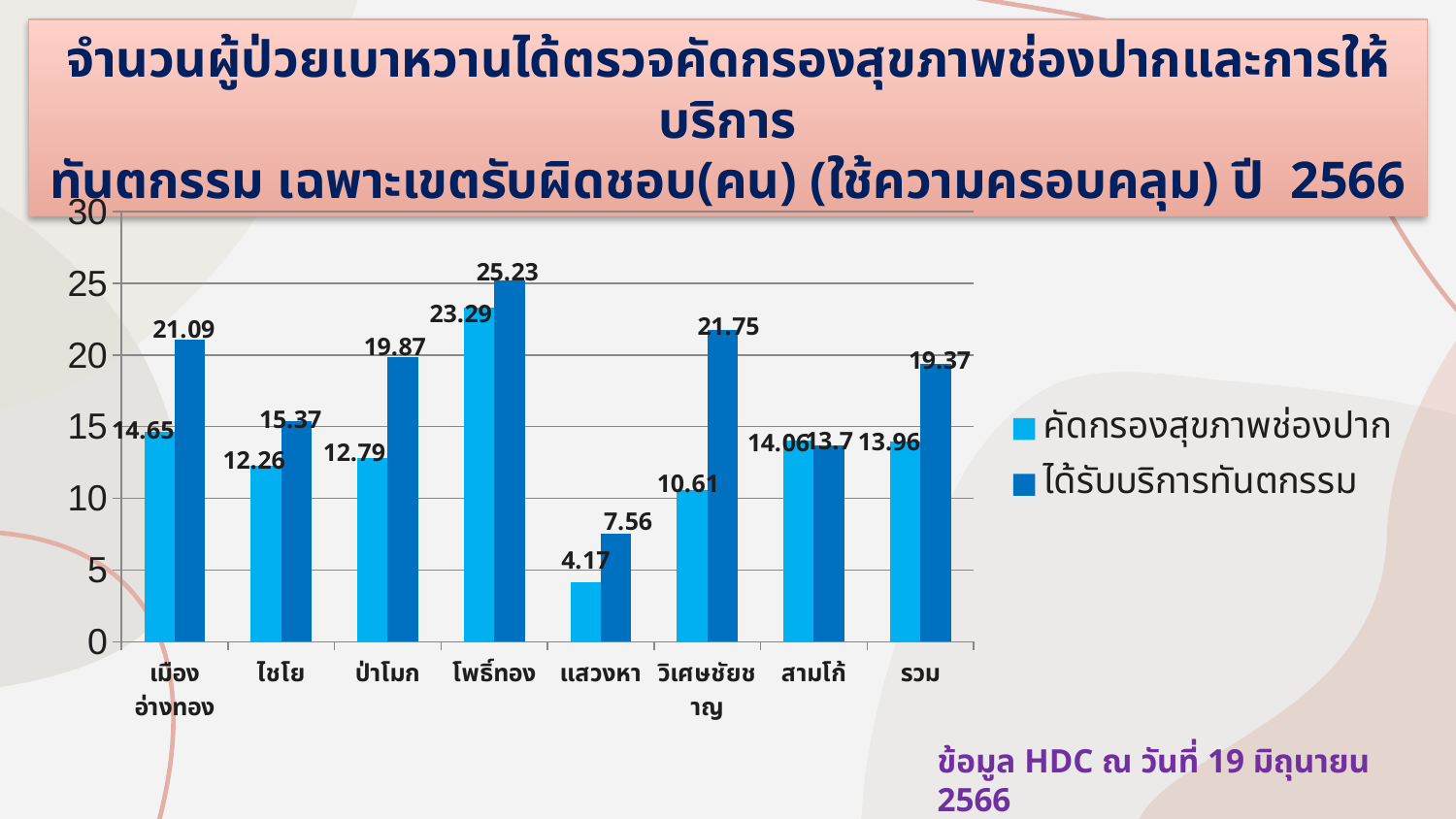
What is the difference between ได้รับบริการทันตกรรม and คัดกรองสุขภาพช่องปาก for เมืองอ่างทอง? 6.44 Which is larger for ป่าโมก: คัดกรองสุขภาพช่องปาก or ได้รับบริการทันตกรรม? ได้รับบริการทันตกรรม What is the value of ได้รับบริการทันตกรรม for โพธิ์ทอง? 25.23 What is the value of คัดกรองสุขภาพช่องปาก for รวม? 13.96 What is the value of ได้รับบริการทันตกรรม for วิเศษชัยชาญ? 21.75 What type of chart is shown on the slide? bar chart Which category has the highest value for ได้รับบริการทันตกรรม? โพธิ์ทอง What is the value of คัดกรองสุขภาพช่องปาก for แสวงหา? 4.17 How many series does the legend list? 2 How many categories are shown on the x axis? 8 Which category has the lowest value for คัดกรองสุขภาพช่องปาก? แสวงหา Is the value of ได้รับบริการทันตกรรม for ไชโย greater or less than 20? less